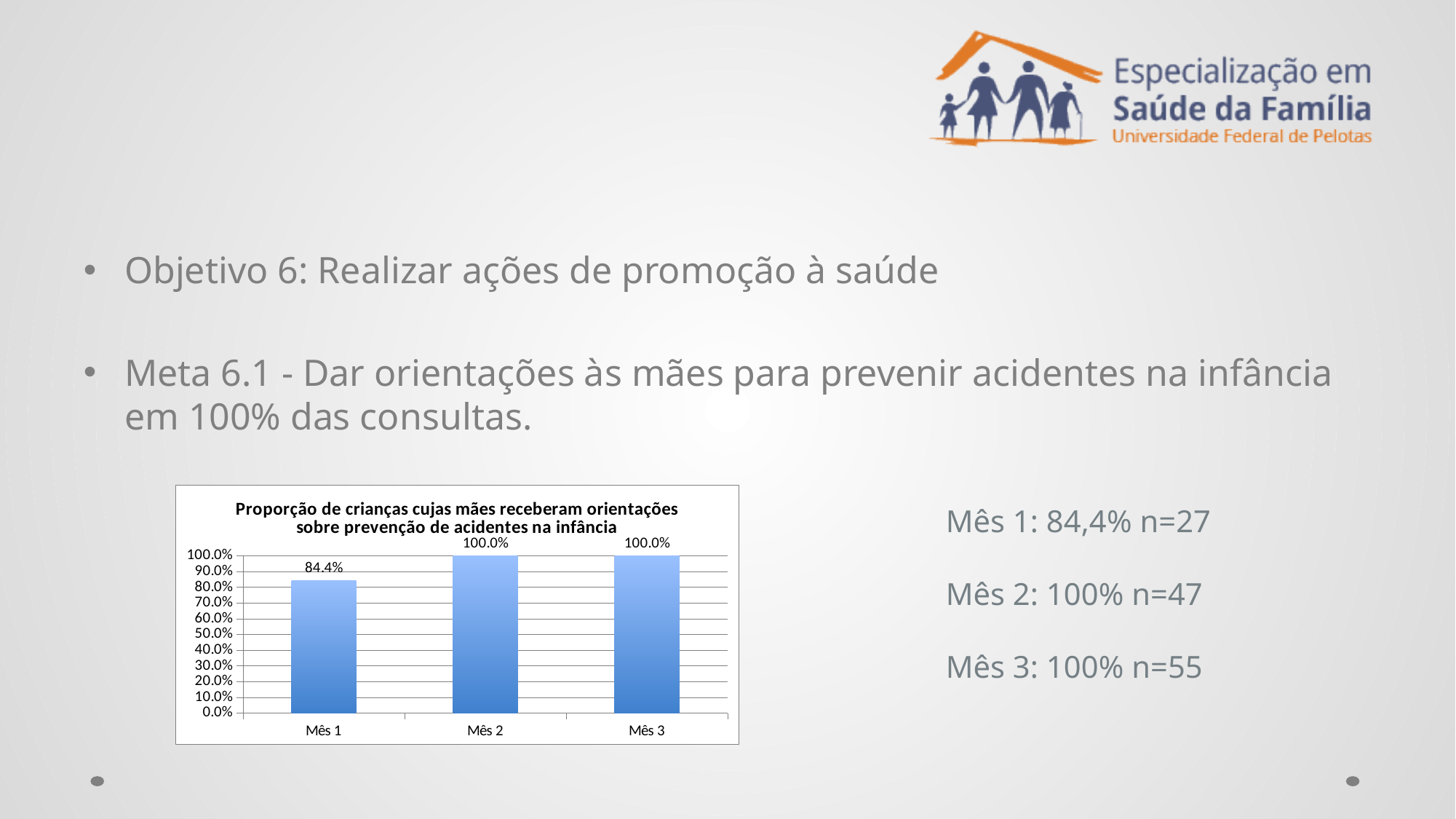
What is the title of the chart? Proporção de crianças cujas mães receberam orientações sobre prevenção de acidentes na infância What is the value for Mês 1? 84.4% Which category has the lowest value? Mês 1 What is the difference between the values for Mês 2 and Mês 1? 15.6% What kind of chart is shown on the slide? bar chart What is the value for Mês 2? 100.0% Do the values rise or fall from Mês 1 to Mês 2? rise How many categories are shown on the x axis? 3 Is the value for Mês 1 greater or less than 90.0%? less Which is larger, the value for Mês 1 or the value for Mês 3? Mês 3 What is the highest value shown on the y axis? 100.0% What is the value for Mês 3? 100.0%